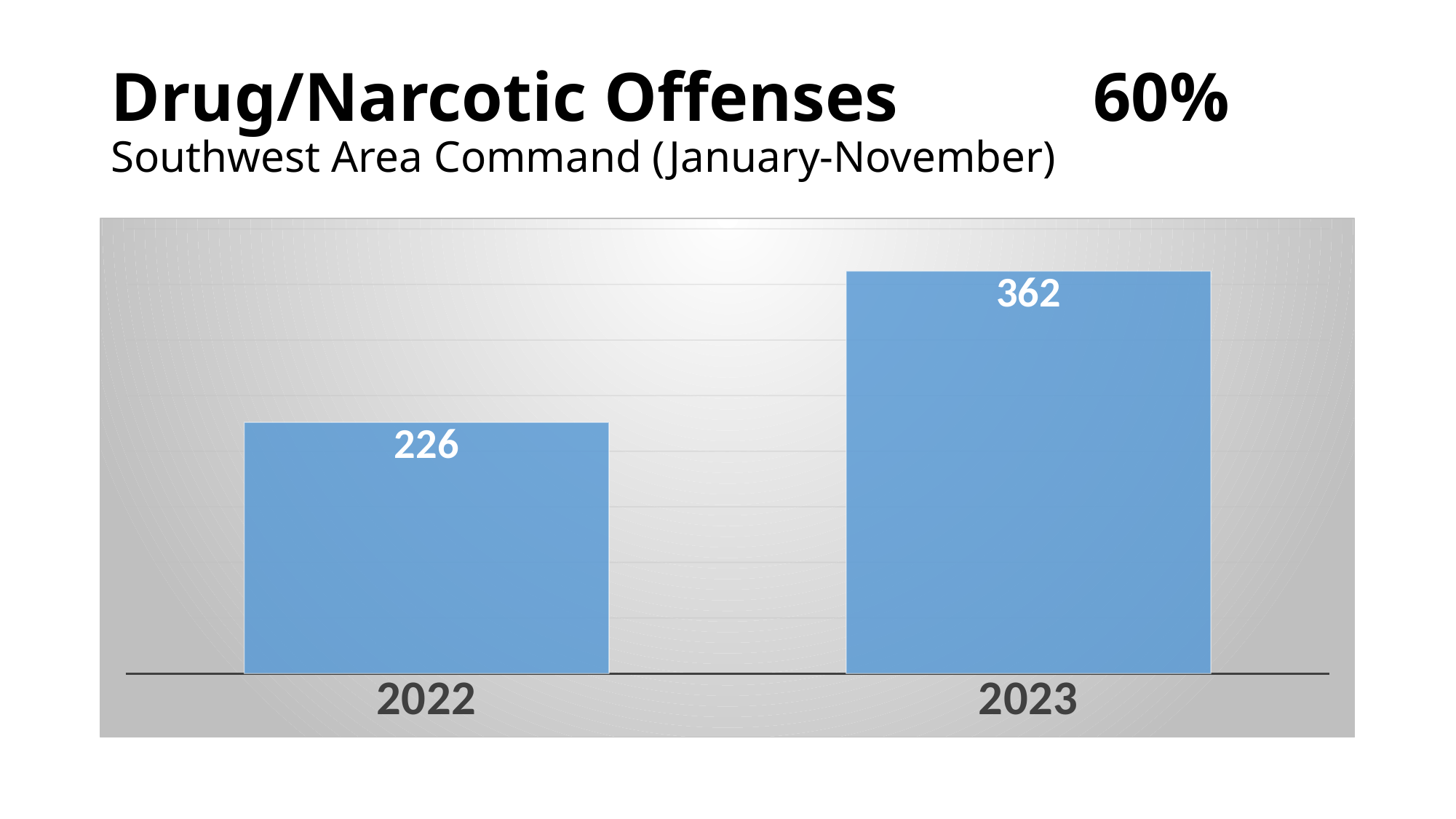
What is the value for 2022? 226 How many years are shown on the chart? 2 What is the value for 2023? 362 What is the difference between the 2023 and 2022 values? 136 Which year has the lower value? 2022 What is the title of the chart? Drug/Narcotic Offenses Do the values rise or fall from 2022 to 2023? rise Is the value for 2023 larger or smaller than the value for 2022? larger What kind of chart is shown on the slide? bar chart What percentage is shown next to the chart title? 60% Which year has the higher value? 2023